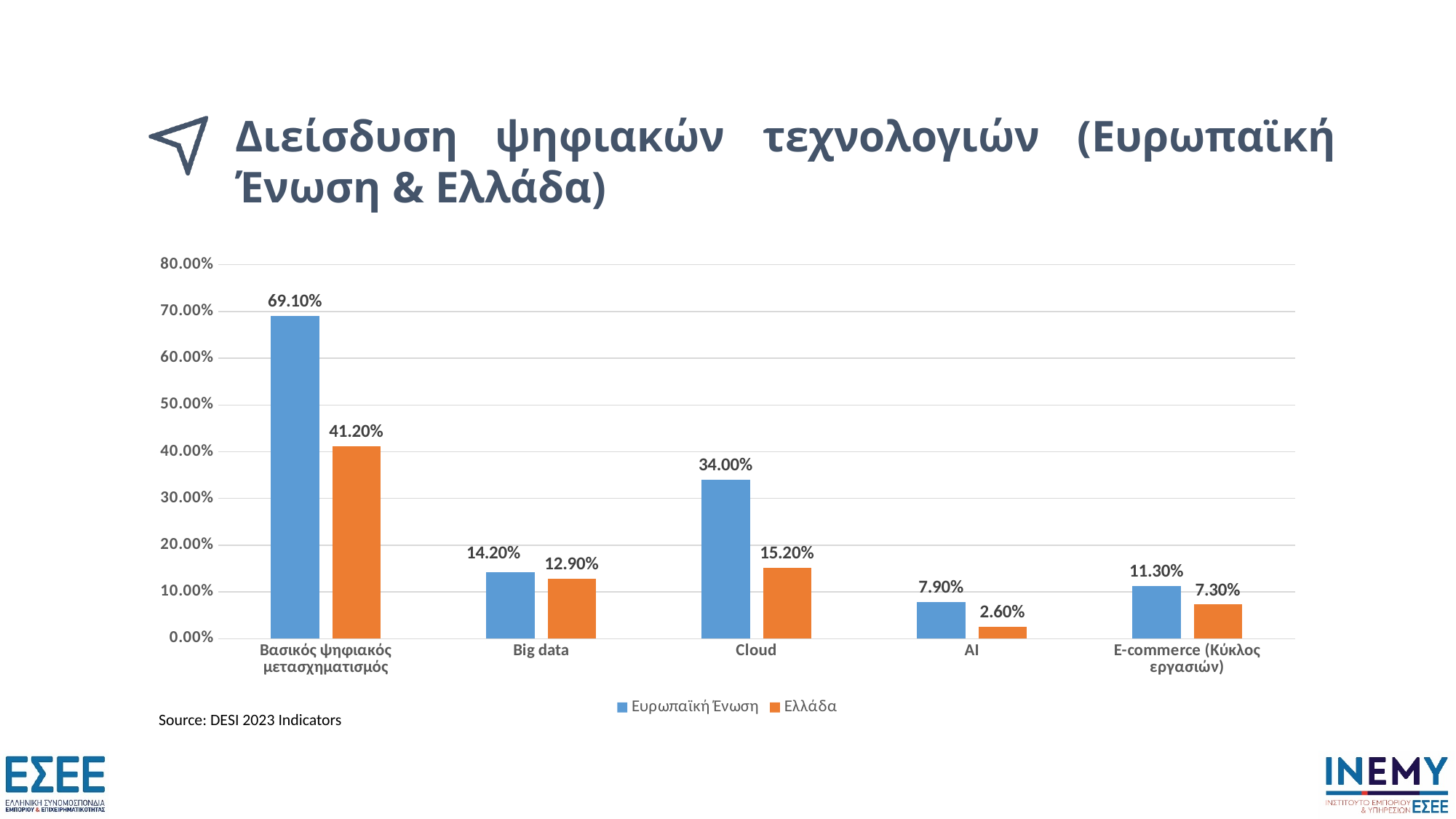
What is the value for Ελλάδα in the Βασικός ψηφιακός μετασχηματισμός category? 41.20% What is the value for Ευρωπαϊκή Ένωση in the Cloud category? 34.00% Which is larger in the Big data category: Ευρωπαϊκή Ένωση or Ελλάδα? Ευρωπαϊκή Ένωση Is the value for Ευρωπαϊκή Ένωση in the Cloud category greater or less than 30.00%? greater Which category has the lowest value for Ελλάδα? AI What is the source cited below the chart? DESI 2023 Indicators How many categories are shown on the x axis? 5 Which category has the highest value for Ευρωπαϊκή Ένωση? Βασικός ψηφιακός μετασχηματισμός What kind of chart is shown on the slide? Bar chart What is the difference between the Ευρωπαϊκή Ένωση and Ελλάδα values in the Βασικός ψηφιακός μετασχηματισμός category? 27.90% What is the value for Ελλάδα in the AI category? 2.60% How many series does the legend list? 2